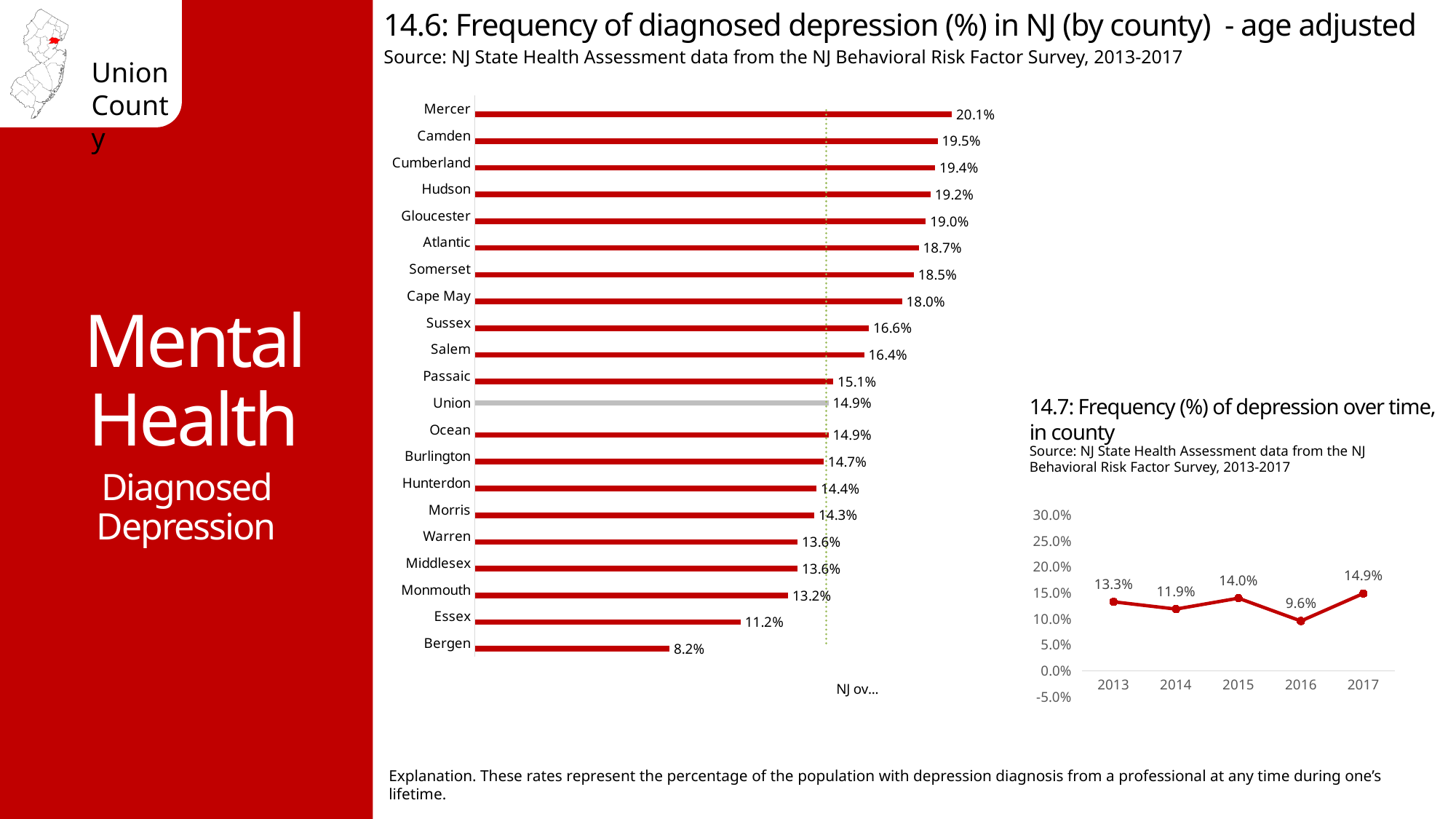
What kind of chart is '14.6: Frequency of diagnosed depression (%) in NJ (by county) - age adjusted'? Bar chart In the chart '14.7: Frequency (%) of depression over time, in county', which year has the highest value? 2017 In the chart '14.6: Frequency of diagnosed depression (%) in NJ (by county) - age adjusted', which is larger, Sussex or Salem? Sussex In the chart '14.6: Frequency of diagnosed depression (%) in NJ (by county) - age adjusted', how many counties are shown? 21 In the chart '14.7: Frequency (%) of depression over time, in county', what is the value for 2016? 9.6% In the chart '14.6: Frequency of diagnosed depression (%) in NJ (by county) - age adjusted', what is the value for Union? 14.9% In the chart '14.7: Frequency (%) of depression over time, in county', what is the difference between 2017 and 2016? 5.3% What kind of chart is '14.7: Frequency (%) of depression over time, in county'? Line chart In the chart '14.6: Frequency of diagnosed depression (%) in NJ (by county) - age adjusted', which county has the highest value? Mercer In the chart '14.6: Frequency of diagnosed depression (%) in NJ (by county) - age adjusted', what is the value for Cape May? 18.0% In the chart '14.6: Frequency of diagnosed depression (%) in NJ (by county) - age adjusted', what is the difference between Mercer and Bergen? 11.9% In the chart '14.6: Frequency of diagnosed depression (%) in NJ (by county) - age adjusted', which county has the lowest value? Bergen